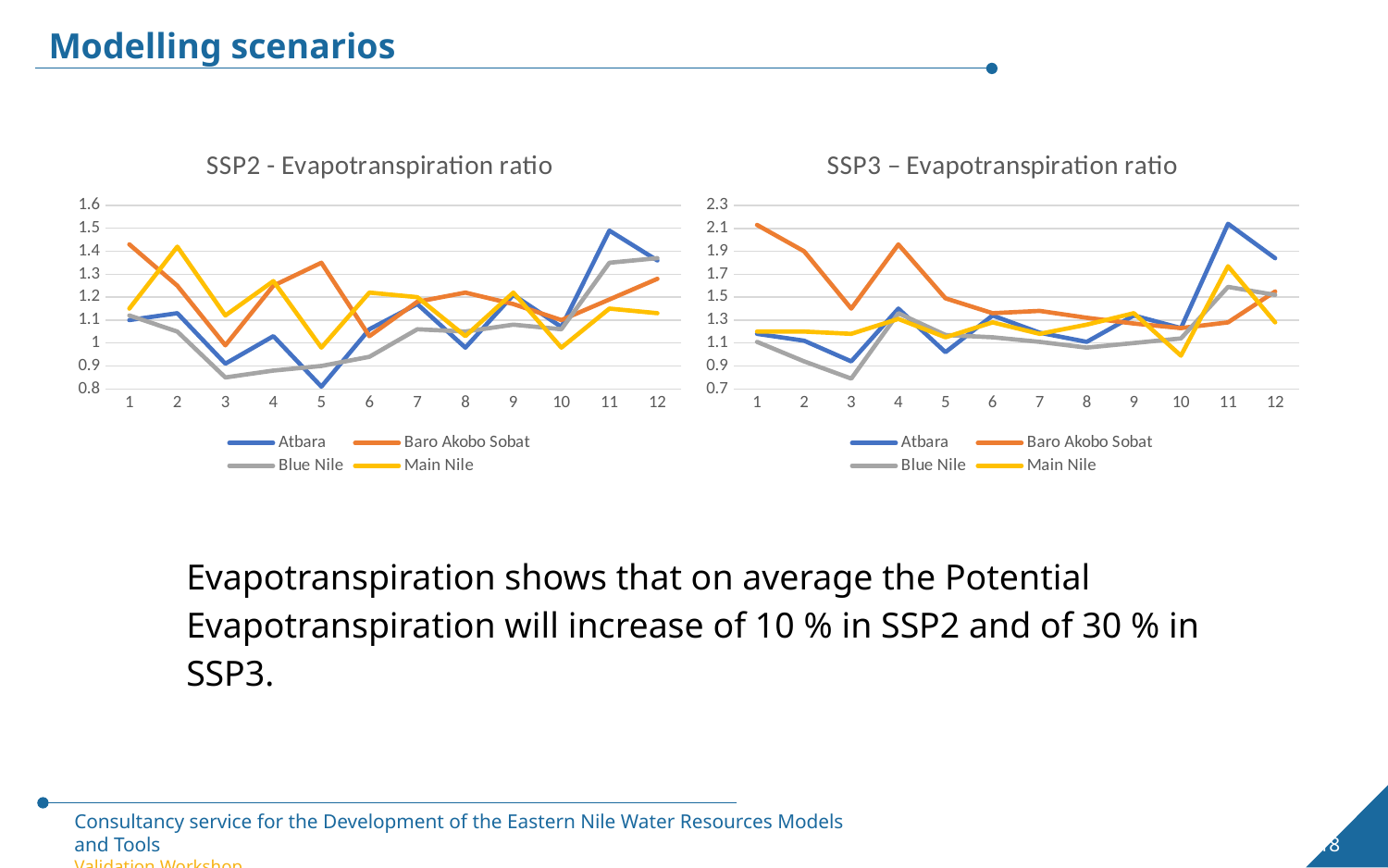
In the SSP2 - Evapotranspiration ratio chart, at which x-axis value does the Atbara series reach its lowest point? 5 In the SSP3 – Evapotranspiration ratio chart, at which x-axis value does the Atbara series reach its highest point? 11 In the SSP3 – Evapotranspiration ratio chart, is the value for Baro Akobo Sobat at 1 greater or less than 1.9? greater In the SSP2 - Evapotranspiration ratio chart, at 11, which is larger: Atbara or Blue Nile? Atbara In the SSP3 – Evapotranspiration ratio chart, which colour is used for the Main Nile series? yellow How many series does the legend of the SSP3 – Evapotranspiration ratio chart list? 4 In the SSP2 - Evapotranspiration ratio chart, is the value for Blue Nile at 3 greater or less than 0.9? less In the SSP2 - Evapotranspiration ratio chart, at which x-axis value does the Atbara series reach its highest point? 11 In the SSP2 - Evapotranspiration ratio chart, is the value for Main Nile at 2 greater or less than 1.3? greater What kind of chart is the SSP2 - Evapotranspiration ratio chart? line chart In the SSP3 – Evapotranspiration ratio chart, at 1, which is larger: Baro Akobo Sobat or Atbara? Baro Akobo Sobat How many points are plotted along the x axis of the SSP2 - Evapotranspiration ratio chart? 12